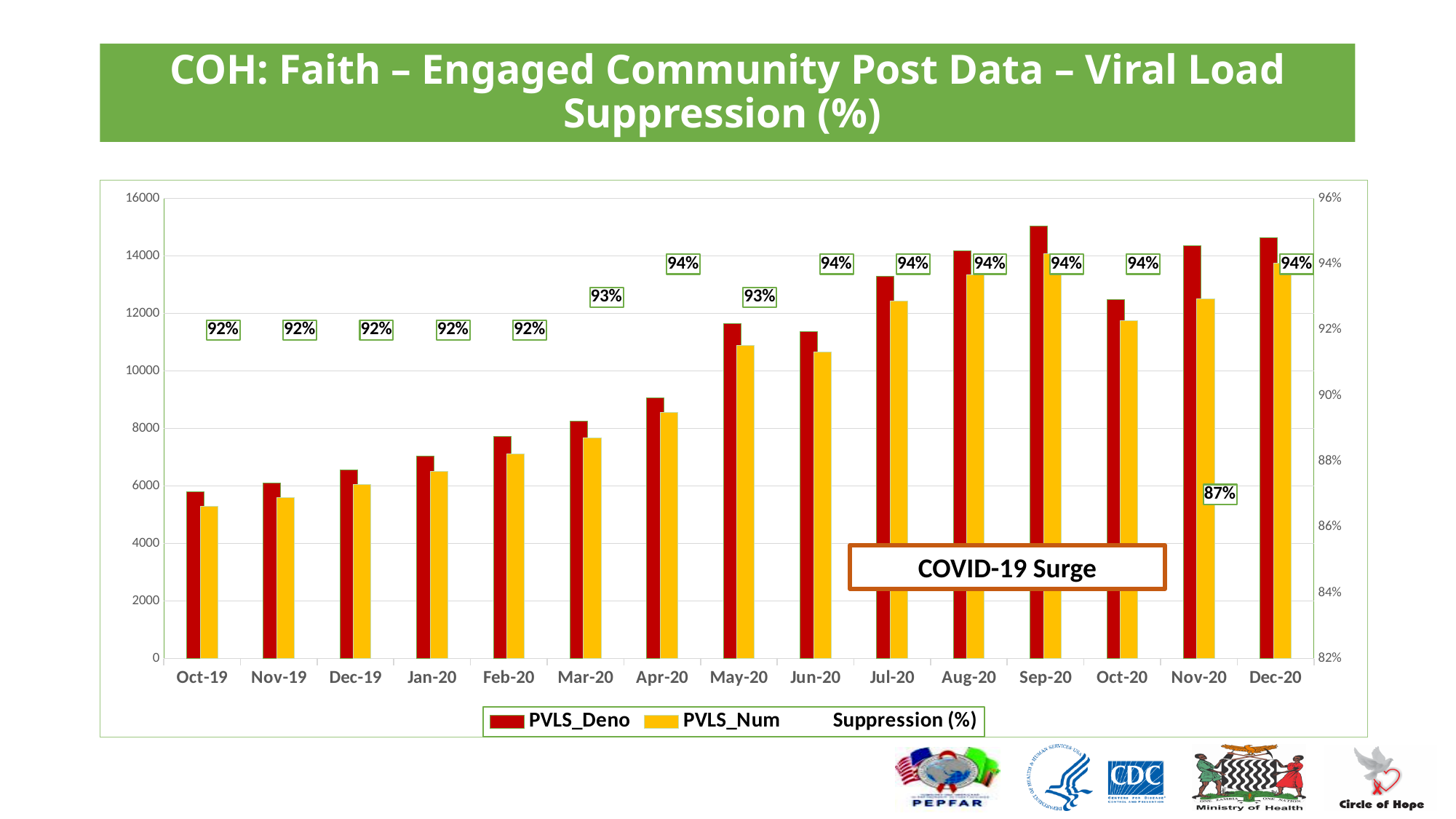
What is the Suppression (%) value for Oct-19? 92% What is the difference between the Suppression (%) values for Dec-20 and Nov-20? 7% Which month has the lowest Suppression (%) value? Nov-20 What is the Suppression (%) value for Nov-20? 87% Does the PVLS_Deno value generally rise or fall from Oct-19 to Sep-20? rise What kind of chart is used to show PVLS_Deno and PVLS_Num? bar chart How many series does the legend list? 3 Is the Suppression (%) value for Apr-20 larger or smaller than the value for Feb-20? larger Is the PVLS_Num value for Oct-19 greater or less than 6000? less Is the PVLS_Deno value for Sep-20 greater or less than 14000? greater What is the Suppression (%) value for Mar-20? 93% How many months are shown on the x axis? 15